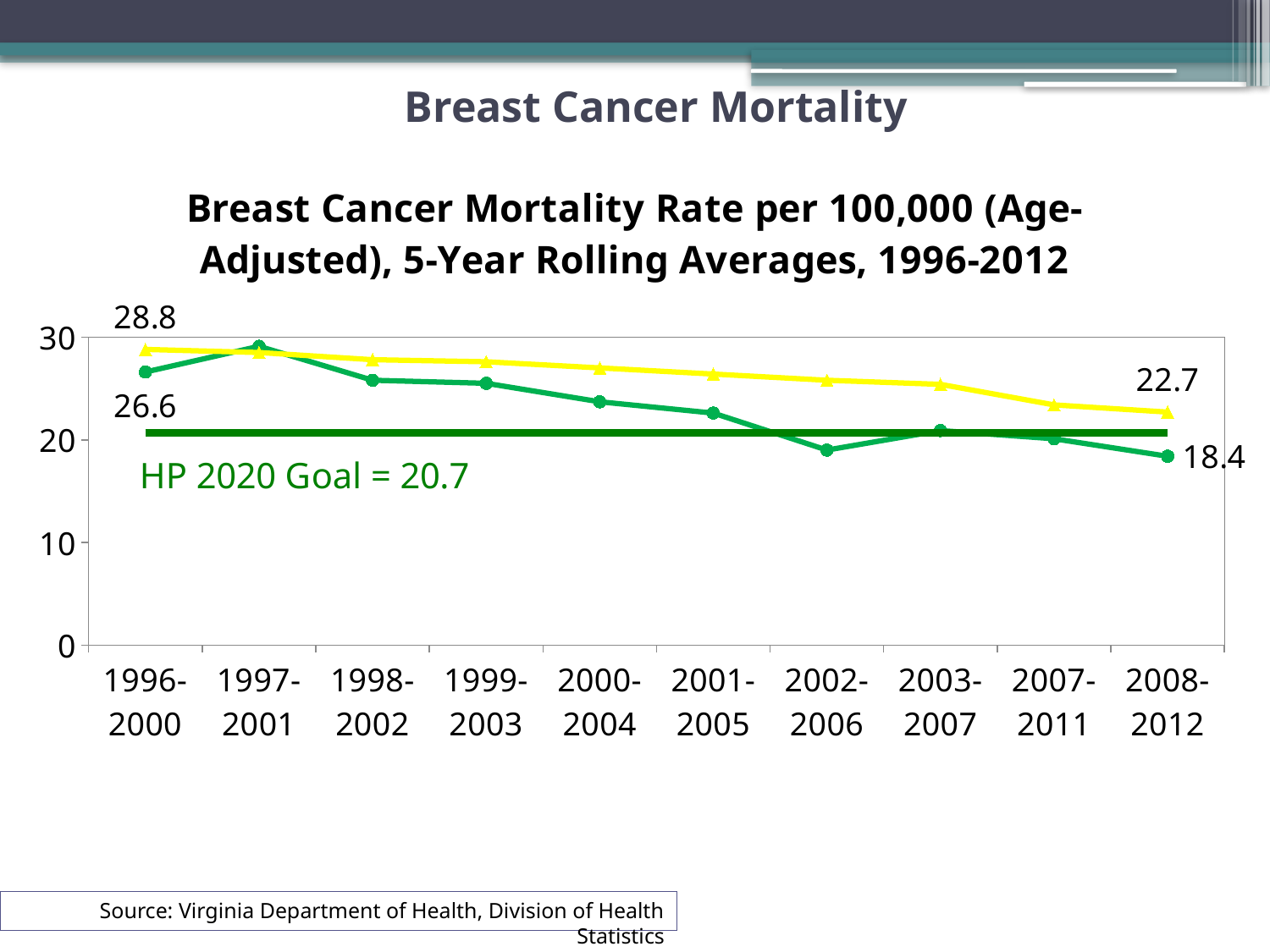
What is the HP 2020 Goal value shown on the chart? 20.7 How many time periods are shown on the x axis of the chart? 10 What kind of chart is shown on the slide? line chart What is the value of the green line for 1996-2000? 26.6 What is the value of the green line for 2008-2012? 18.4 What is the value of the yellow line for 1996-2000? 28.8 What is the value of the yellow line for 2008-2012? 22.7 By how much did the green line's value fall from 1996-2000 to 2008-2012? 8.2 For 2008-2012, which line has the larger value, the yellow line or the green line? yellow line Is the value of the yellow line for 2003-2007 greater or less than 20? greater By how much did the yellow line's value fall from 1996-2000 to 2008-2012? 6.1 Does the yellow line rise or fall from 1996-2000 to 2008-2012? fall